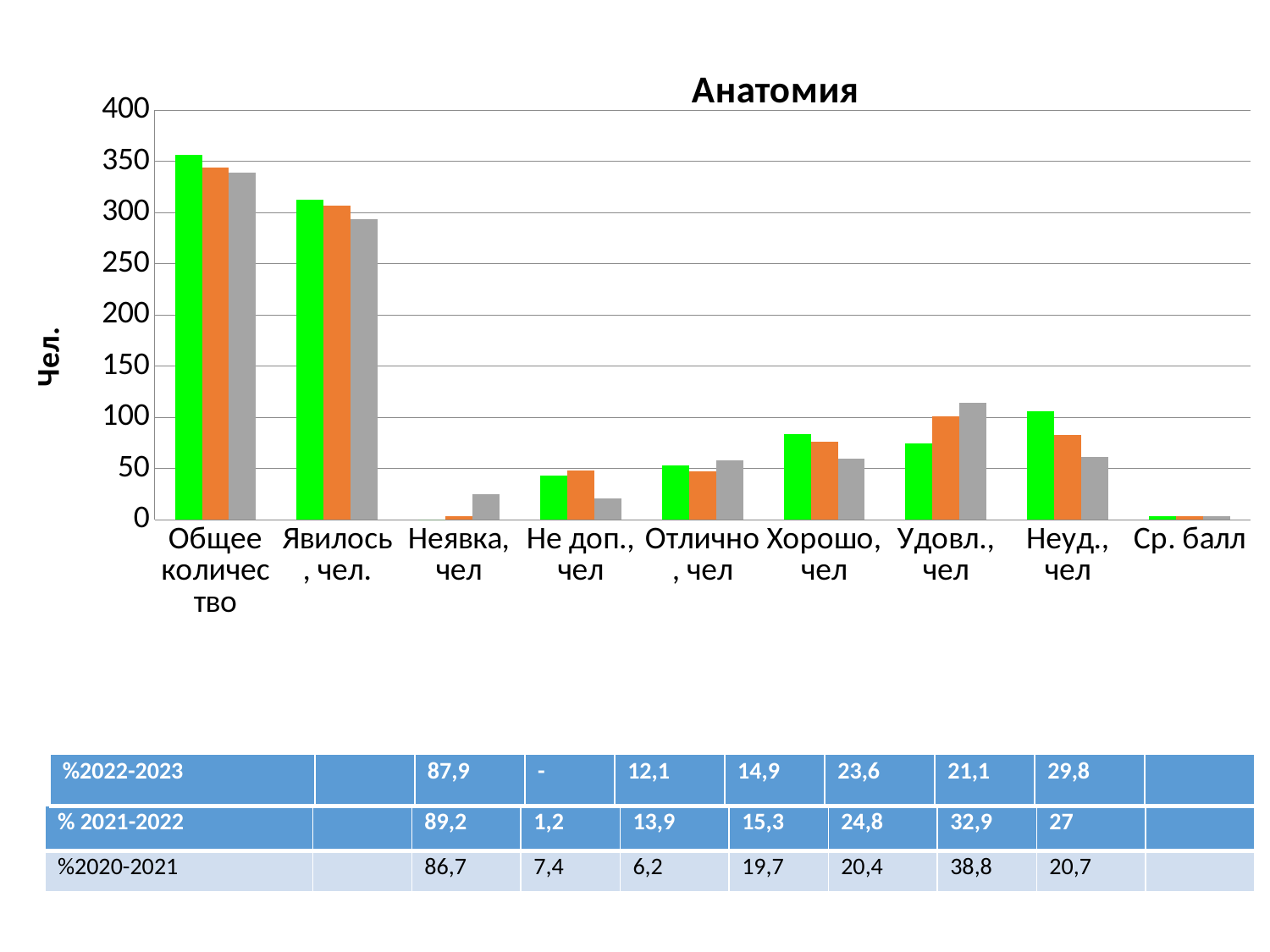
Is the value of the gray bar for Неявка, чел greater or less than 50? less In the Удовл., чел category, which bar is taller: the green bar or the gray bar? the gray bar In the Неуд., чел category, which bar is taller: the green bar or the gray bar? the green bar Which category has the tallest bars in the chart? Общее количество How many categories are shown along the x axis of the chart? 9 Which category has the shortest bars in the chart? Ср. балл Is the value of the gray bar for Явилось, чел. greater or less than 300? less What kind of chart is shown on the slide? bar chart What is the label on the vertical axis of the chart? Чел. Is the value of the orange bar for Общее количество greater or less than 350? less What is the title of the chart? Анатомия